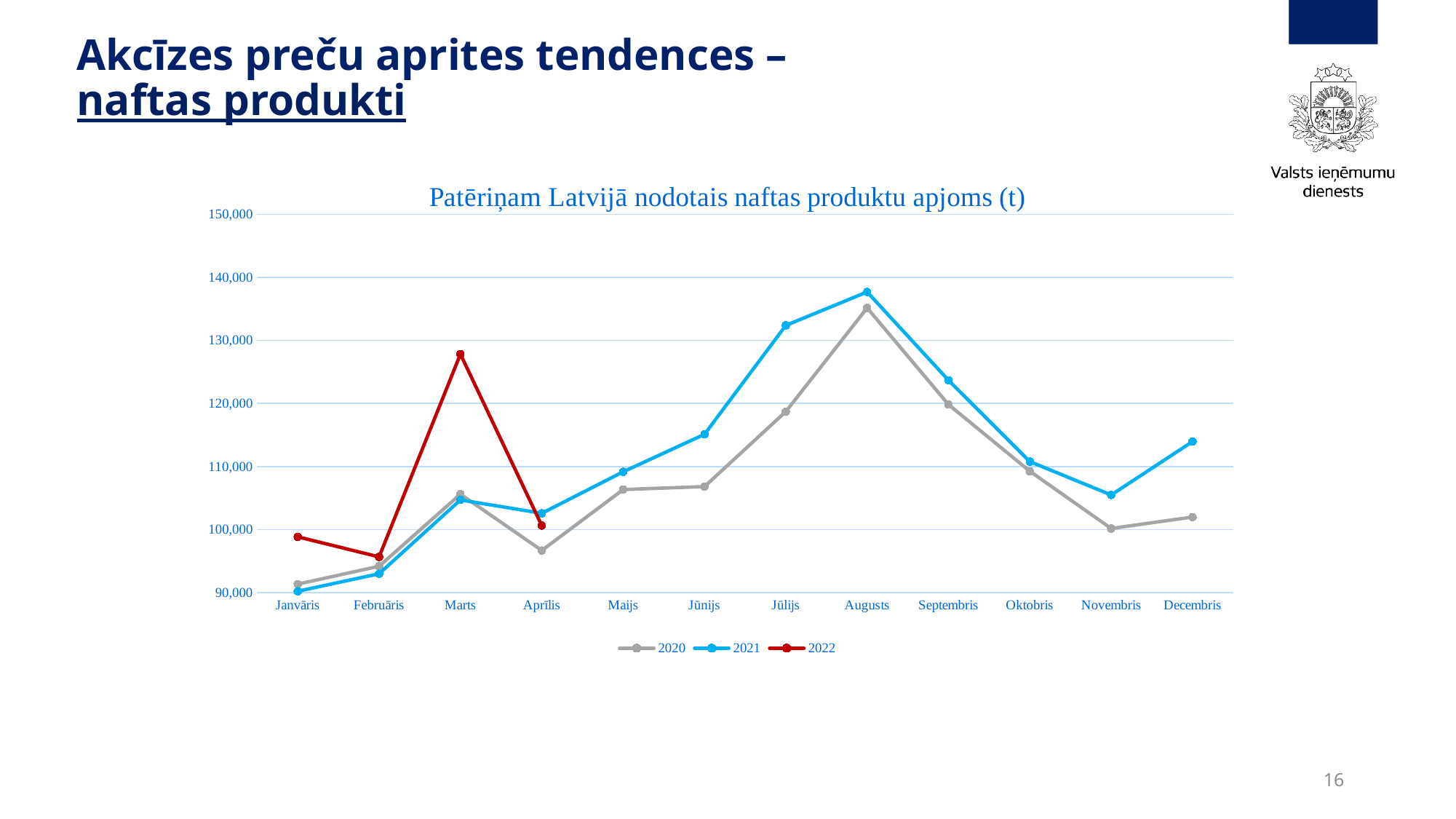
What kind of chart is shown on the slide? Line chart In which month does the 2020 series reach its highest value? Augusts What is the title of the chart? Patēriņam Latvijā nodotais naftas produktu apjoms (t) In which month does the 2022 series reach its highest value? Marts In which month does the 2021 series reach its highest value? Augusts In which month is the 2021 series at its lowest? Janvāris Is the 2022 value for Marts greater or less than 120,000? greater How many series does the legend list? 3 Is the 2020 value for Aprīlis greater or less than 100,000? less Is the 2021 value for Augusts greater or less than 130,000? greater How many months are shown on the x axis? 12 In Jūlijs, which series has the larger value, 2020 or 2021? 2021